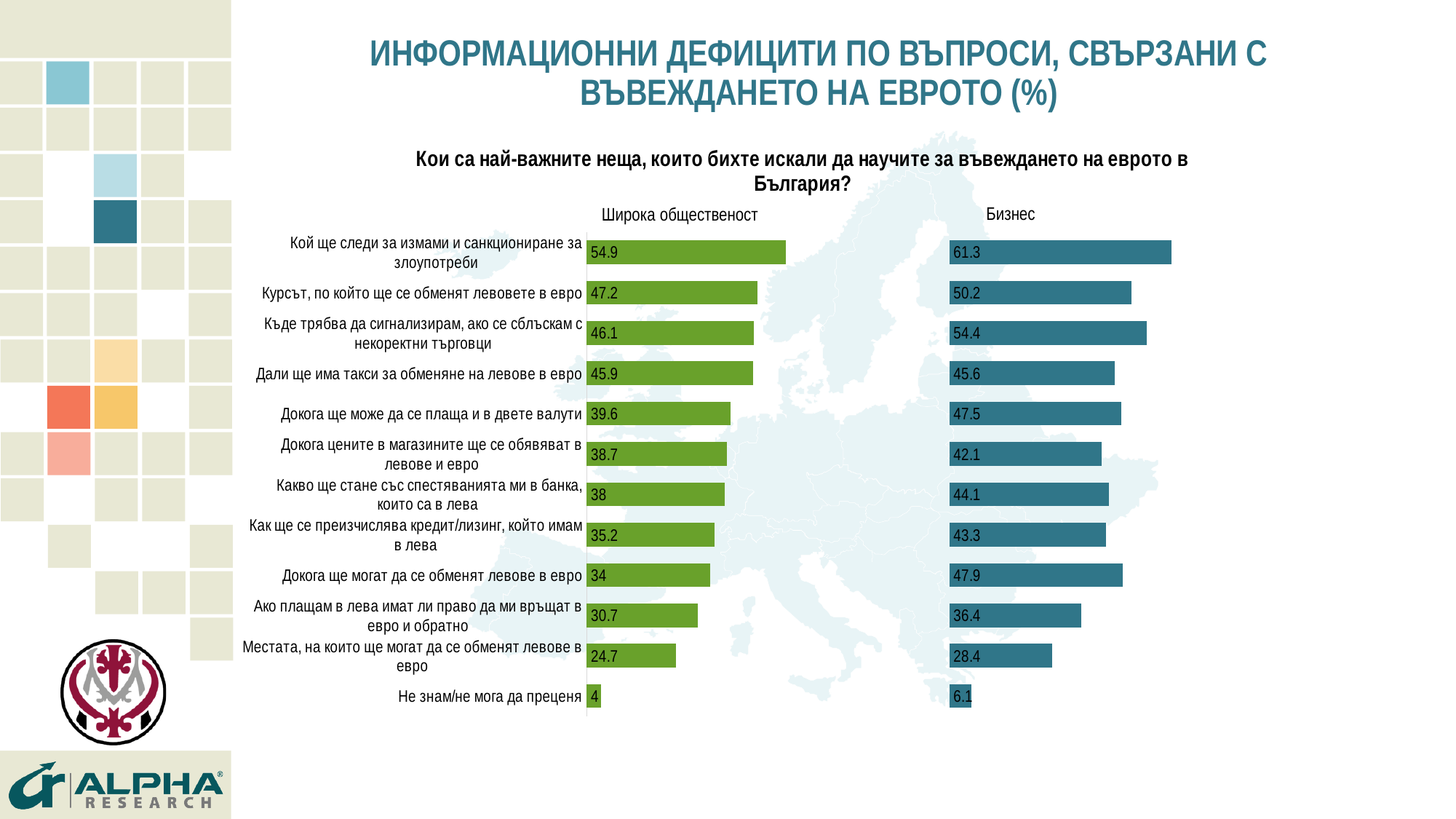
What is the difference between the "Бизнес" and "Широка общественост" values for "Докога ще могат да се обменят левове в евро"? 13.9 In the "Широка общественост" chart, which category has the lowest value? Не знам/не мога да преценя In the "Бизнес" chart, is the value for "Докога ще може да се плаща и в двете валути" larger than the value for "Докога цените в магазините ще се обявяват в левове и евро"? Yes In the "Бизнес" chart, what is the value for "Докога ще могат да се обменят левове в евро"? 47.9 In the "Широка общественост" chart, what is the value for "Курсът, по който ще се обменят левовете в евро"? 47.2 In the "Бизнес" chart, which category has the highest value? Кой ще следи за измами и санкциониране за злоупотреби For "Дали ще има такси за обменяне на левове в евро", which chart shows the larger value, "Широка общественост" or "Бизнес"? Широка общественост How many categories are shown in the "Широка общественост" chart? 12 In the "Широка общественост" chart, what is the value for "Местата, на които ще могат да се обменят левове в евро"? 24.7 What colour are the bars in the "Широка общественост" chart? Green What is the difference between the "Бизнес" value and the "Широка общественост" value for "Кой ще следи за измами и санкциониране за злоупотреби"? 6.4 What type of chart is used for the "Бизнес" data? Bar chart